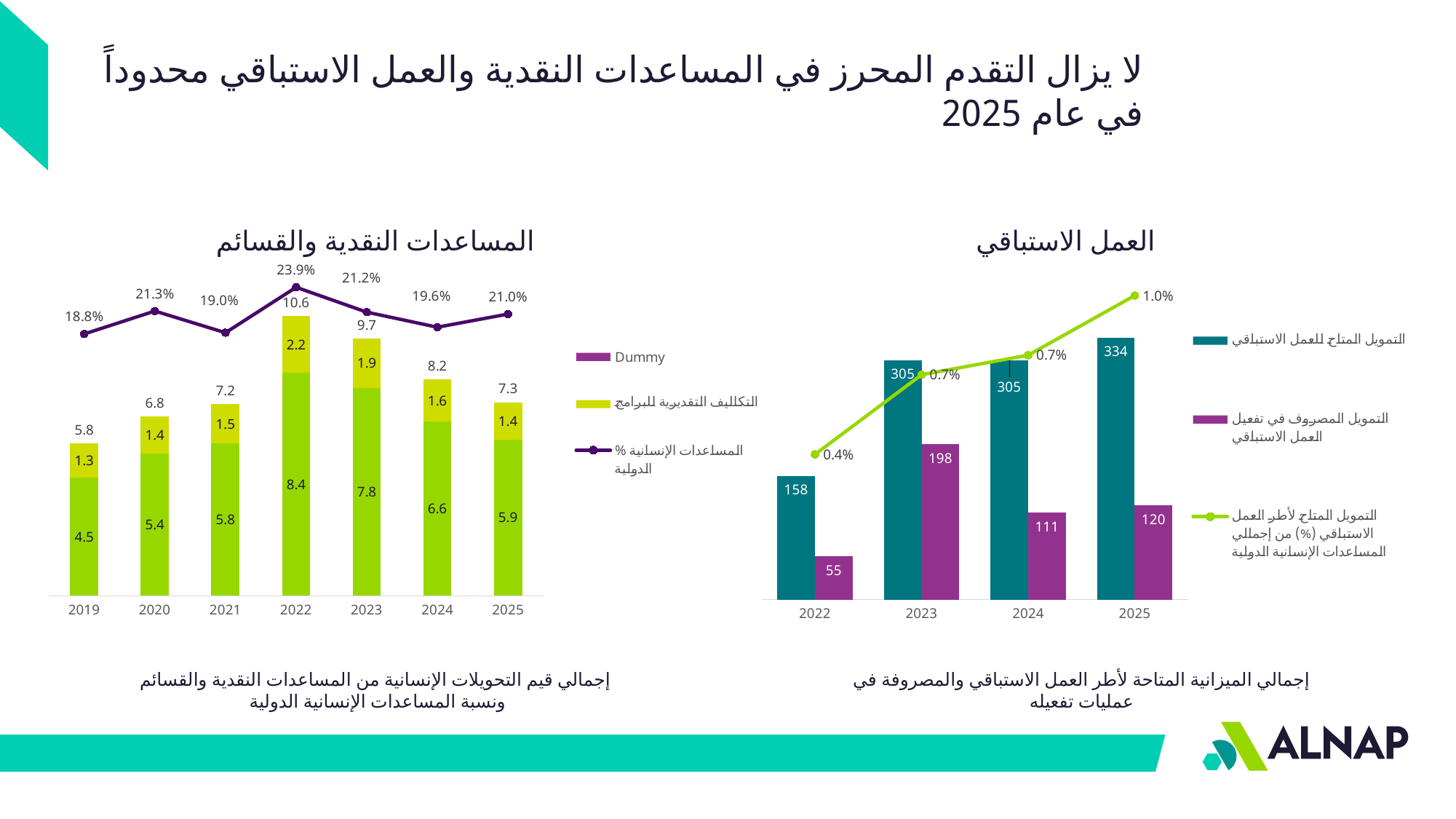
In the left chart (المساعدات النقدية والقسائم), how many years are shown on the x axis? 7 In the right chart (العمل الاستباقي), what is the value of the teal bar (التمويل المتاح للعمل الاستباقي) for 2025? 334 In the right chart (العمل الاستباقي), which year has the lowest purple bar (التمويل المصروف)? 2022 In the left chart (المساعدات النقدية والقسائم), what percentage is shown on the line for 2019? 18.8% In the left chart (المساعدات النقدية والقسائم), what is the difference between the total for 2022 and the total for 2025? 3.3 In the right chart (العمل الاستباقي), does the green percentage line rise or fall from 2022 to 2025? rises In the left chart (المساعدات النقدية والقسائم), what is the value of the lower (green) segment of the 2023 bar? 7.8 In the left chart (المساعدات النقدية والقسائم), which year has the highest value on the percentage line? 2022 How many entries does the legend of the right chart (العمل الاستباقي) list? 3 In the right chart (العمل الاستباقي), what is the difference between the teal bar and the purple bar for 2023? 107 In the left chart (المساعدات النقدية والقسائم), what is the total value labelled above the 2022 bar? 10.6 In the right chart (العمل الاستباقي), is the purple bar (التمويل المصروف) larger in 2023 or in 2024? 2023